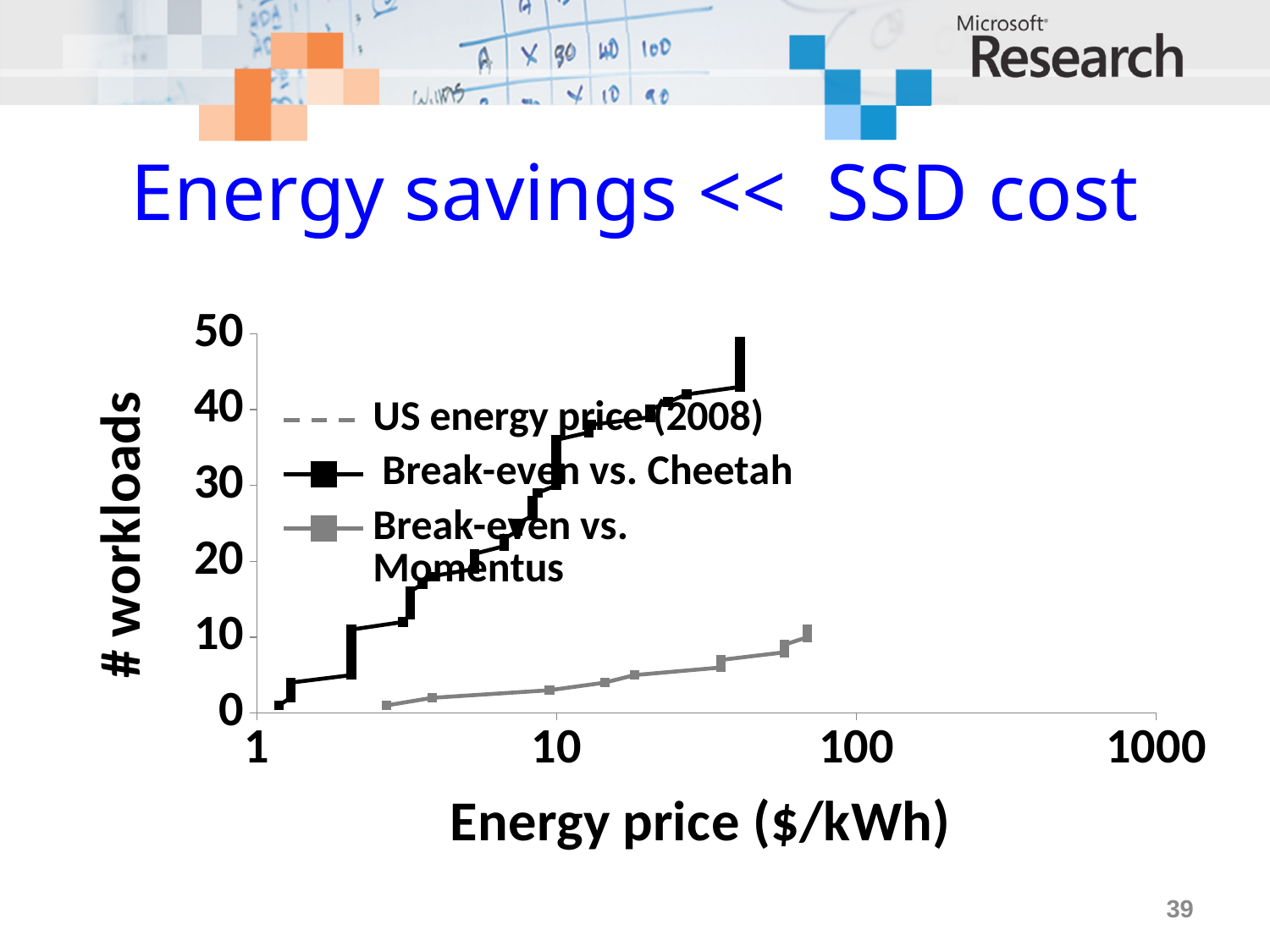
How many series does the legend list? 3 What is the label of the y axis? # workloads At an energy price of 10 $/kWh, which series has more workloads: Break-even vs. Cheetah or Break-even vs. Momentus? Break-even vs. Cheetah Is the highest value of the Break-even vs. Cheetah series greater or less than 40 workloads? greater Does the Break-even vs. Cheetah series rise or fall as energy price increases? rise At an energy price of 10 $/kWh, is the Break-even vs. Momentus value greater or less than 10 workloads? less At an energy price of 10 $/kWh, is the Break-even vs. Cheetah value greater or less than 20 workloads? greater What kind of chart is shown on the slide? line chart Does the Break-even vs. Momentus series rise or fall as energy price increases? rise Which series reaches the highest number of workloads on the chart? Break-even vs. Cheetah What is the label of the x axis? Energy price ($/kWh)